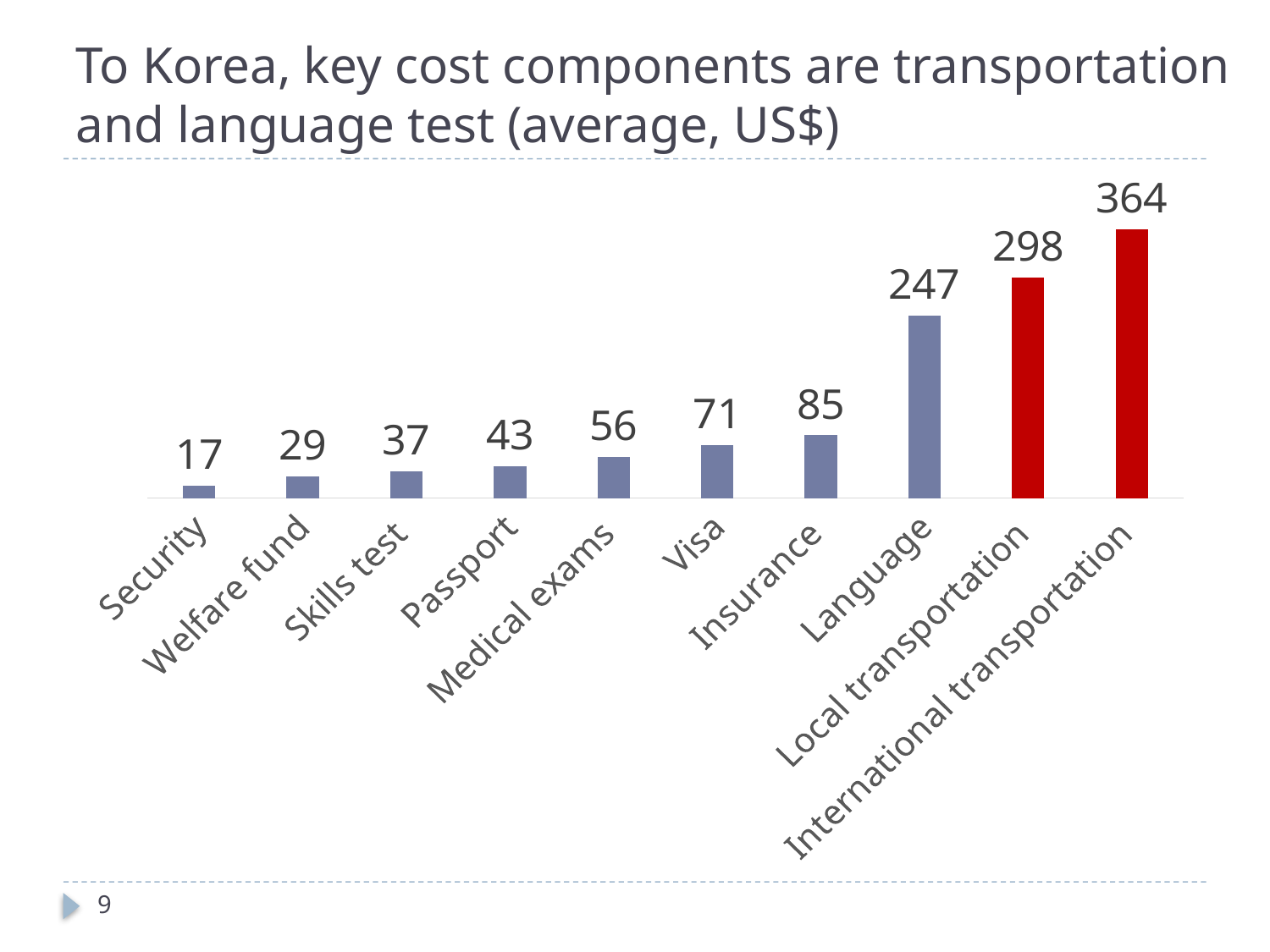
Do the values rise or fall from left to right along the x axis? Rise Which category has the lowest value? Security What is the value for Local transportation? 298 What is the difference between International transportation and Local transportation? 66 What kind of chart is this? Bar chart Which is larger, Passport or Skills test? Passport Which category has the highest value? International transportation How many categories are shown in the chart? 10 What is the value for Medical exams? 56 Which two bars are coloured red? Local transportation and International transportation What is the value for Language? 247 What is the difference between Insurance and Visa? 14